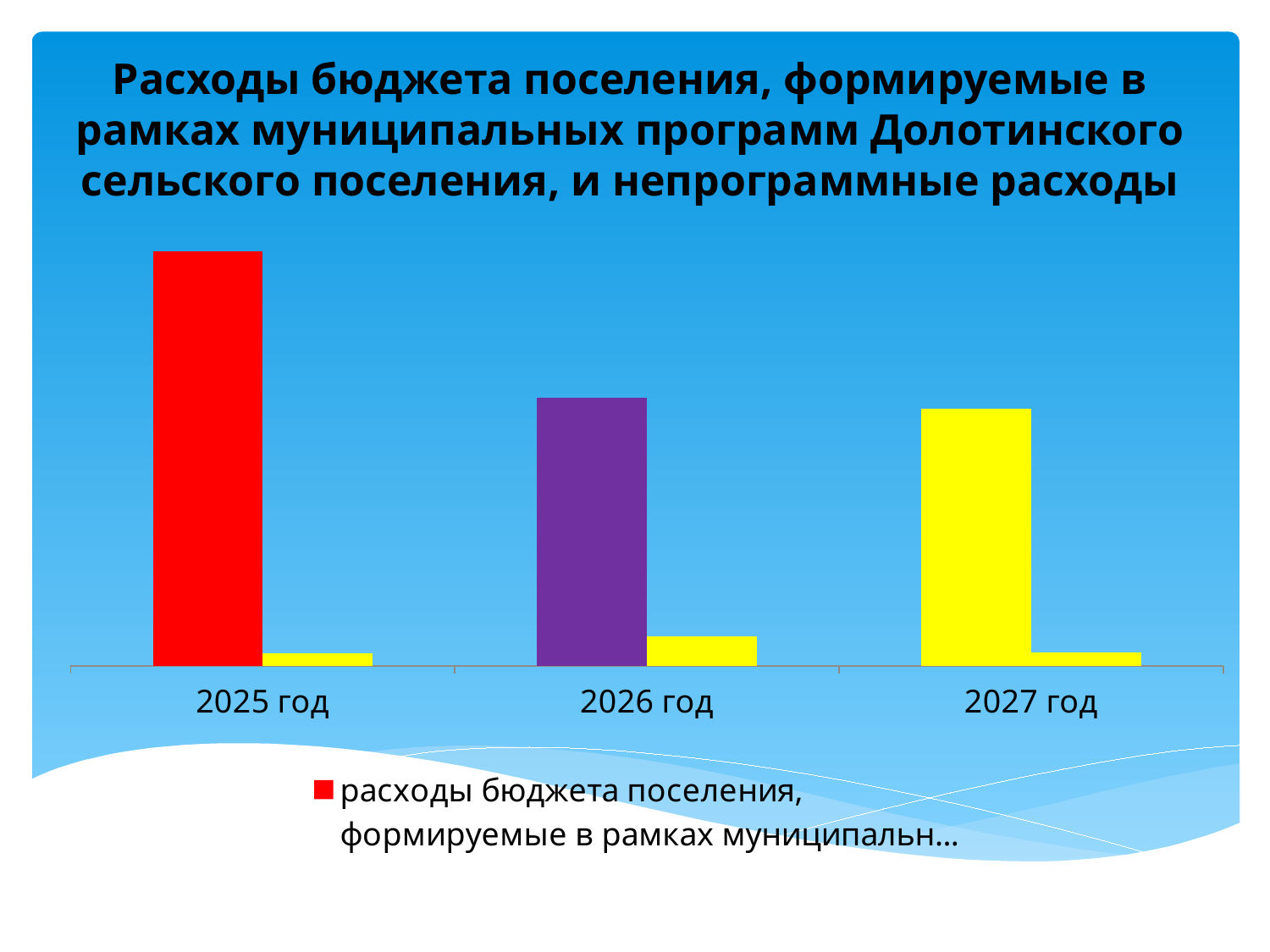
Is the first bar for 2025 год taller or shorter than the first bar for 2027 год? taller How many year categories are shown on the x axis? 3 What kind of chart is shown on the slide? bar chart Which year label appears furthest to the right on the x axis? 2027 год Does the first bar in each group rise or fall from 2025 год to 2026 год? fall What colour is the first bar for 2026 год? purple Is the first bar for 2025 год taller or shorter than the first bar for 2026 год? taller What colour is the first bar for 2025 год? red In which year is the second (small yellow) bar the tallest? 2026 год In each year group, is the first bar taller or shorter than the second bar? taller How many entries does the legend list? 1 Which year has the tallest bar for the programme expenditure series (the first bar in each group)? 2025 год